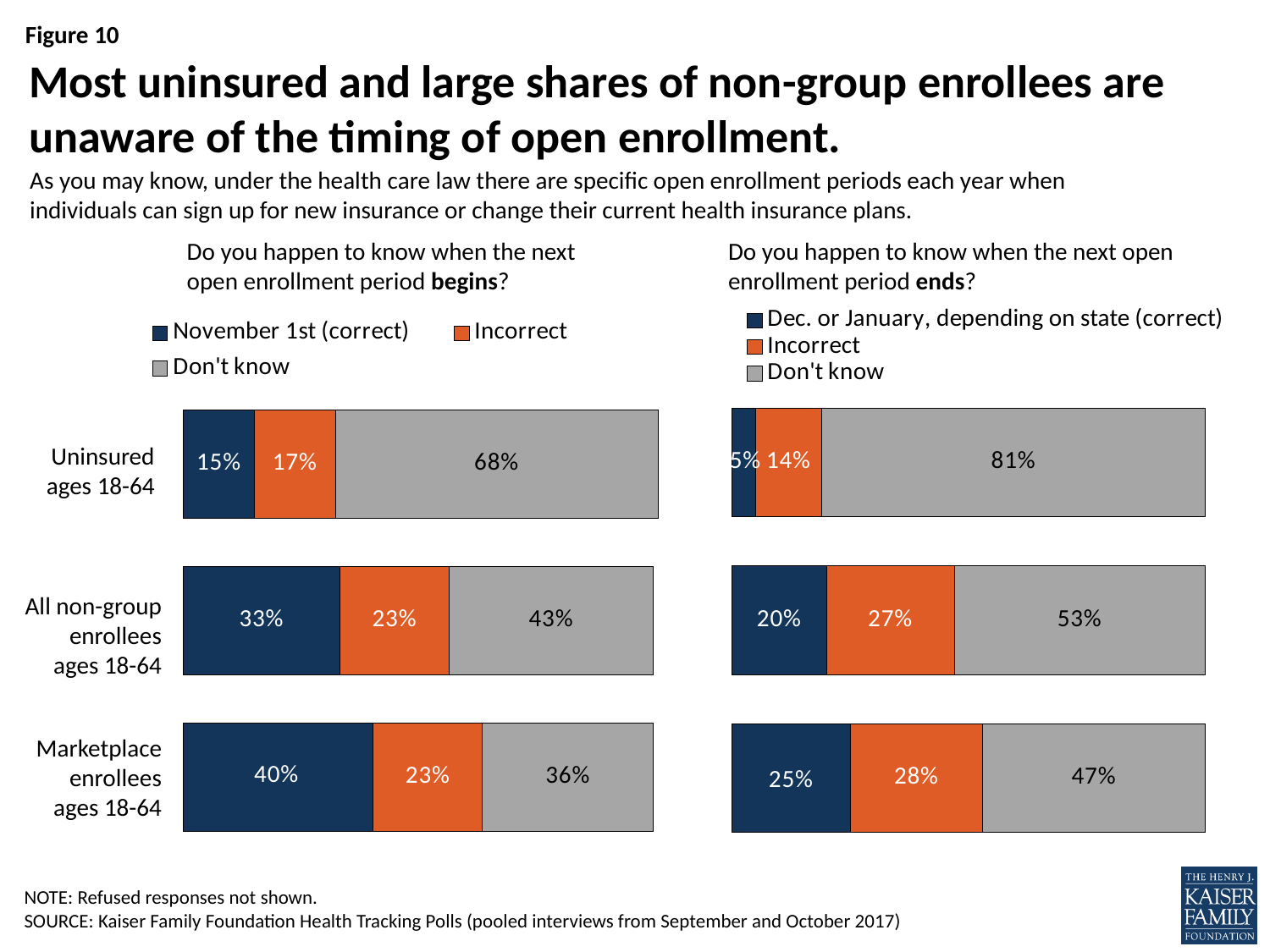
In the right chart (when the next open enrollment period ends), what share of uninsured ages 18-64 answered "Don't know"? 81% In the right chart (when the next open enrollment period ends), what share of Marketplace enrollees ages 18-64 gave the correct answer (Dec. or January, depending on state)? 25% In the left chart (when the next open enrollment period begins), which group has the highest share answering November 1st (correct)? Marketplace enrollees ages 18-64 In the left chart (when the next open enrollment period begins), what share of all non-group enrollees ages 18-64 answered incorrectly? 23% How many series does the legend of the right chart (when the next open enrollment period ends) list? 3 What type of chart is used in the left chart (when the next open enrollment period begins)? Stacked bar chart In the right chart (when the next open enrollment period ends), which is larger for all non-group enrollees ages 18-64: the Incorrect share or the correct share? Incorrect In the left chart (when the next open enrollment period begins), what is the difference between the "Don't know" share for uninsured ages 18-64 and for Marketplace enrollees ages 18-64? 32 percentage points In the left chart (when the next open enrollment period begins), what share of uninsured ages 18-64 answered "Don't know"? 68% In the right chart (when the next open enrollment period ends), what is the combined share of Incorrect and "Don't know" responses for Marketplace enrollees ages 18-64? 75% How many groups (categories) are shown in the left chart (when the next open enrollment period begins)? 3 In the right chart (when the next open enrollment period ends), which group has the lowest share giving the correct answer? Uninsured ages 18-64